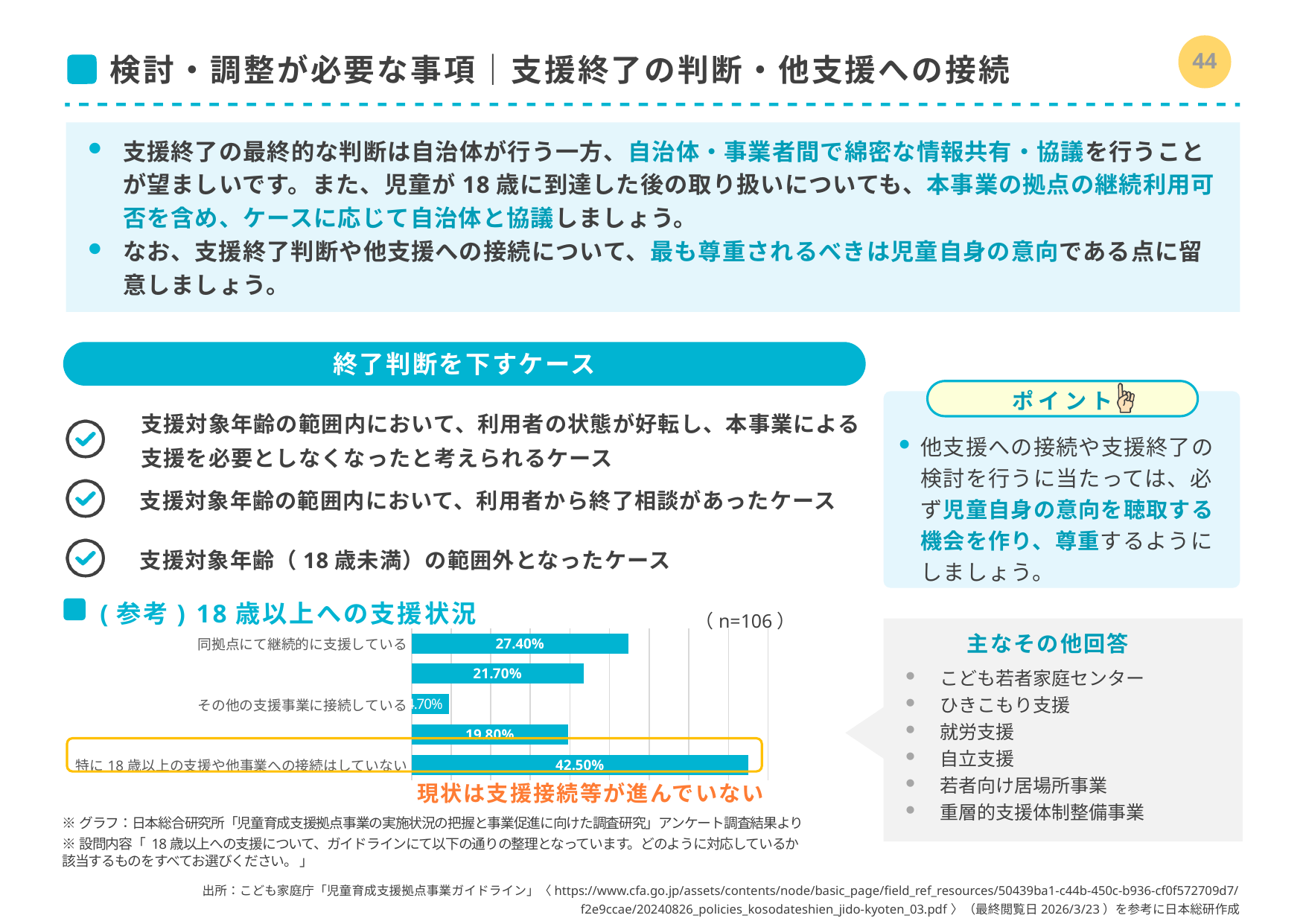
What is the value for 特に18歳以上の支援や他事業への接続はしていない in the bar chart? 42.50% What is the title of the chart? （参考）18歳以上への支援状況 What is the difference between the values for 特に18歳以上の支援や他事業への接続はしていない and 同拠点にて継続的に支援している? 15.10% How many bars are plotted in the chart? 5 Which category has the highest value in the bar chart? 特に18歳以上の支援や他事業への接続はしていない What kind of chart is shown on the slide? bar chart Which category has the lowest value in the bar chart? その他の支援事業に接続している What is the difference between the values for 同拠点にて継続的に支援している and その他の支援事業に接続している? 22.70% Which is larger: the value for 同拠点にて継続的に支援している or the value for その他の支援事業に接続している? 同拠点にて継続的に支援している What is the value for 同拠点にて継続的に支援している in the bar chart? 27.40% What is the value for その他の支援事業に接続している in the bar chart? 4.70% What sample size (n) is shown next to the chart? n=106